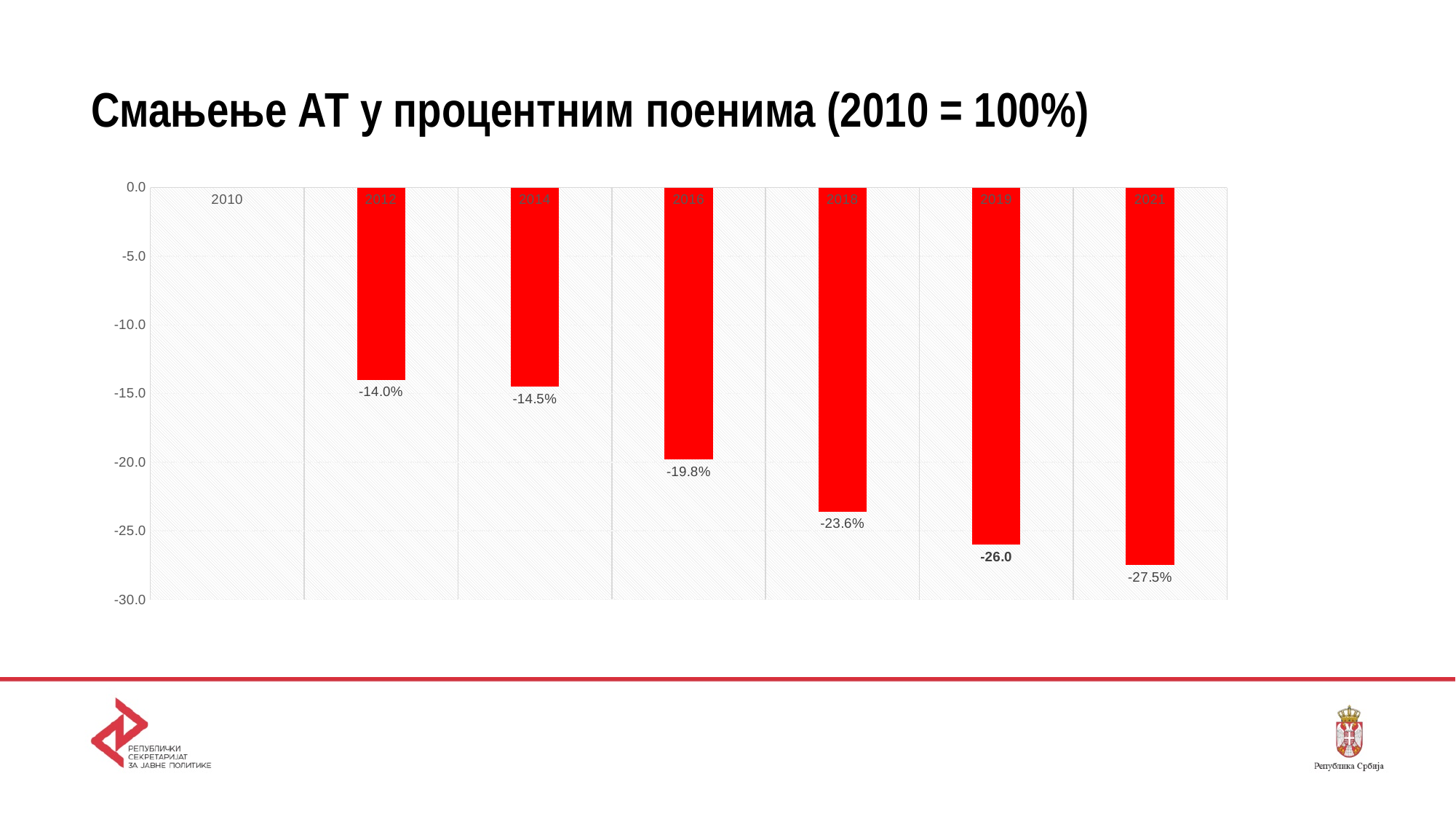
What is the value shown for 2016? -19.8% What is the data label shown for 2019? -26.0 What kind of chart is shown on the slide? bar chart What is the value shown for 2018? -23.6% How many year categories are shown on the x axis? 7 Do the values rise or fall from 2012 to 2021? fall Which year has the largest reduction shown on the chart? 2021 What is the value shown for 2021? -27.5% Which year has the lowest (most negative) value? 2021 What is the value shown for 2012? -14.0% Is the value for 2014 greater or less than -15.0? greater What is the title of the chart? Смањење АТ у процентним поенима (2010 = 100%)